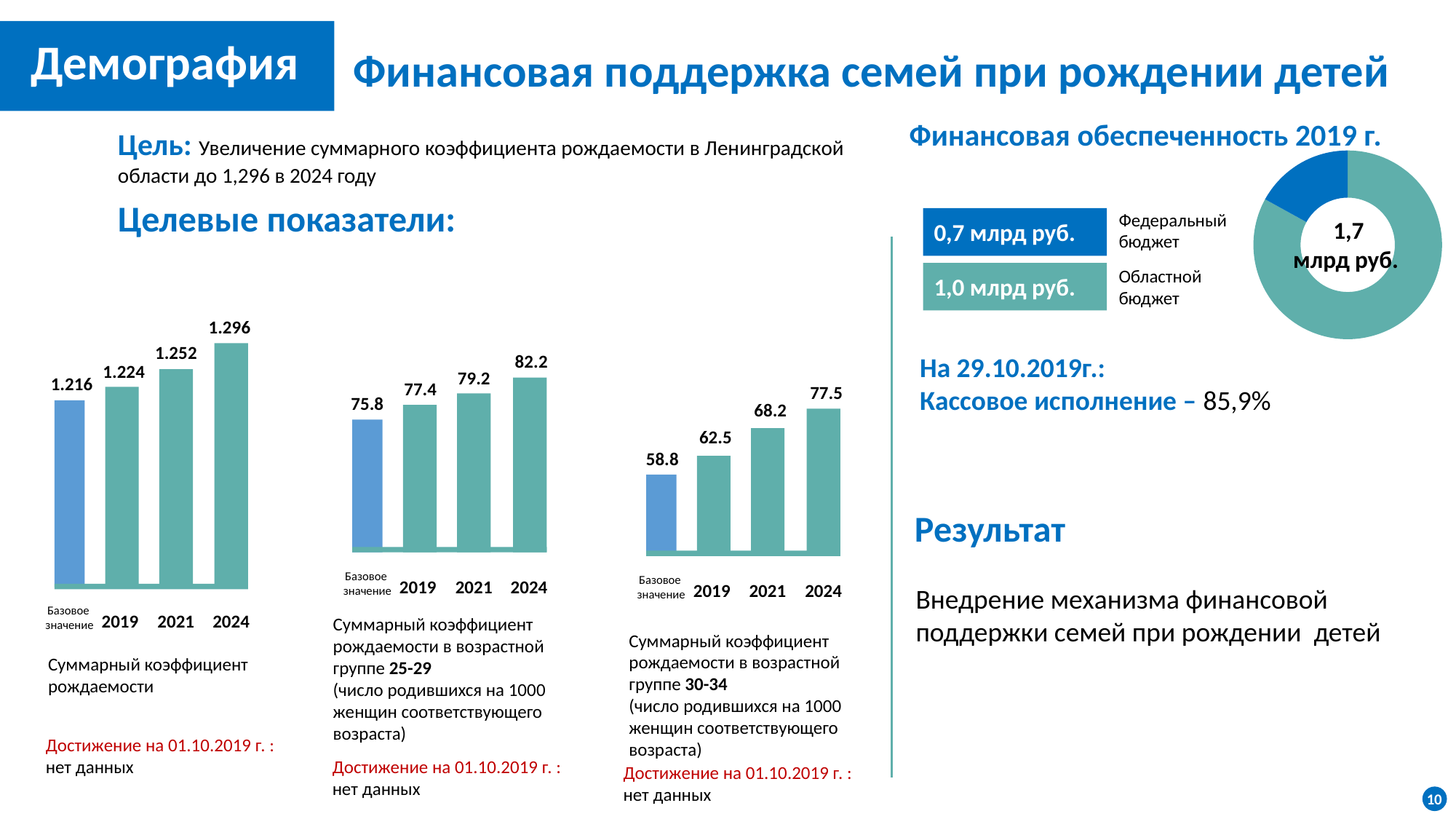
In the right bar chart (age group 30-34), what is the value for 2019? 62.5 In the donut chart (Финансовая обеспеченность 2019 г.), what is the value for Областной бюджет? 1,0 млрд руб. In the middle bar chart (age group 25-29), which category has the highest value? 2024 In the left bar chart (Суммарный коэффициент рождаемости), what is the base value (Базовое значение)? 1.216 How many bars are in the left bar chart (Суммарный коэффициент рождаемости)? 4 What kind of chart is used for Финансовая обеспеченность 2019 г.? donut (pie) chart In the right bar chart (age group 30-34), what is the difference between the 2024 value and the base value? 18.7 In the right bar chart (age group 30-34), which category has the lowest value? Базовое значение In the middle bar chart (age group 25-29), do the values rise or fall from the base value to 2024? rise In the donut chart (Финансовая обеспеченность 2019 г.), which is larger: Федеральный бюджет or Областной бюджет? Областной бюджет In the middle bar chart (age group 25-29), what is the value for 2021? 79.2 In the left bar chart (Суммарный коэффициент рождаемости), what is the value for 2024? 1.296